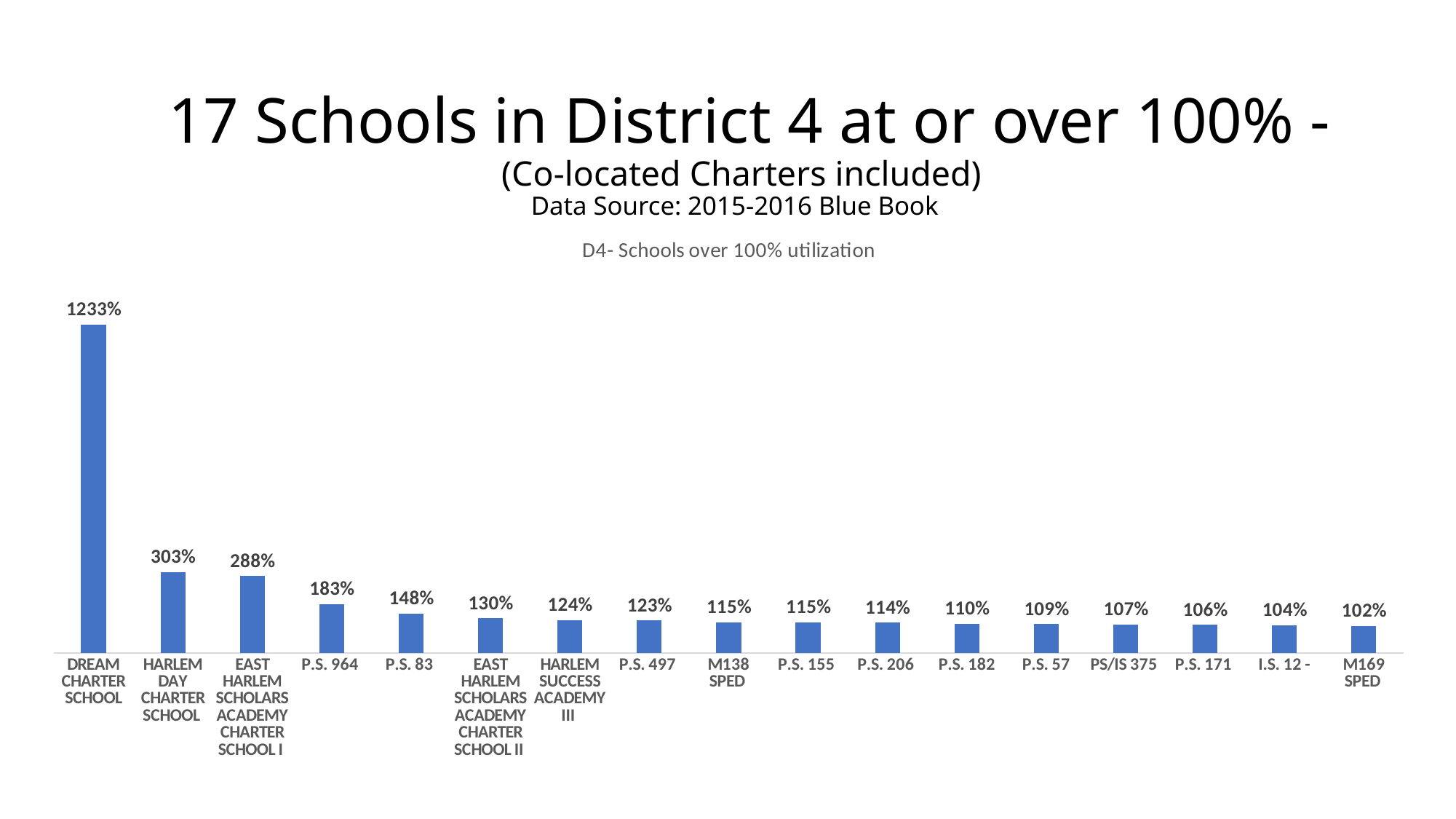
What kind of chart is shown on the slide? Bar chart Which school has the lowest utilization? M169 SPED How many schools are shown in the chart? 17 What is the difference between the utilization of HARLEM DAY CHARTER SCHOOL and EAST HARLEM SCHOLARS ACADEMY CHARTER SCHOOL I? 15% Which has a higher utilization, P.S. 83 or P.S. 497? P.S. 83 Do the values rise or fall from left to right along the x axis? Fall What is the utilization value for DREAM CHARTER SCHOOL? 1233% What is the utilization value for M169 SPED? 102% What is the utilization value for HARLEM SUCCESS ACADEMY III? 124% What is the utilization value for P.S. 964? 183% What is the title of the chart? D4- Schools over 100% utilization Which school has the highest utilization? DREAM CHARTER SCHOOL